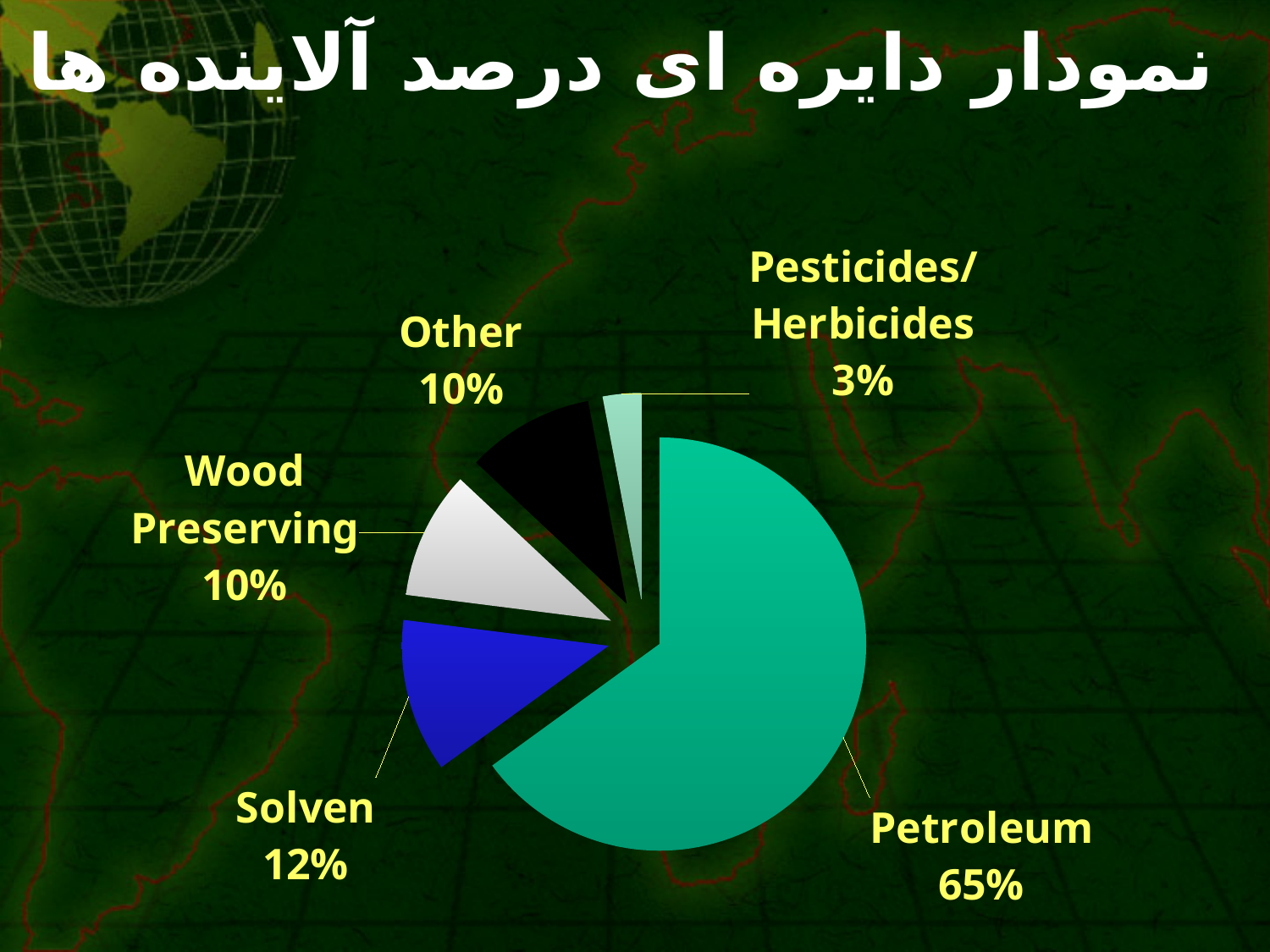
What percentage is shown for Solven? 12% Which is larger, the share for Solven or the share for Other? Solven What percentage is shown for Wood Preserving? 10% What kind of chart is shown on the slide? Pie chart What colour is the Solven slice? Blue How many slices does the pie chart have? 5 What percentage of the pie does Petroleum account for? 65% What is the combined share of Wood Preserving and Other? 20% What is the difference in percentage points between Petroleum and Solven? 53 Which category has the largest slice of the pie? Petroleum What percentage is shown for Pesticides/Herbicides? 3% Which category has the smallest slice of the pie? Pesticides/Herbicides